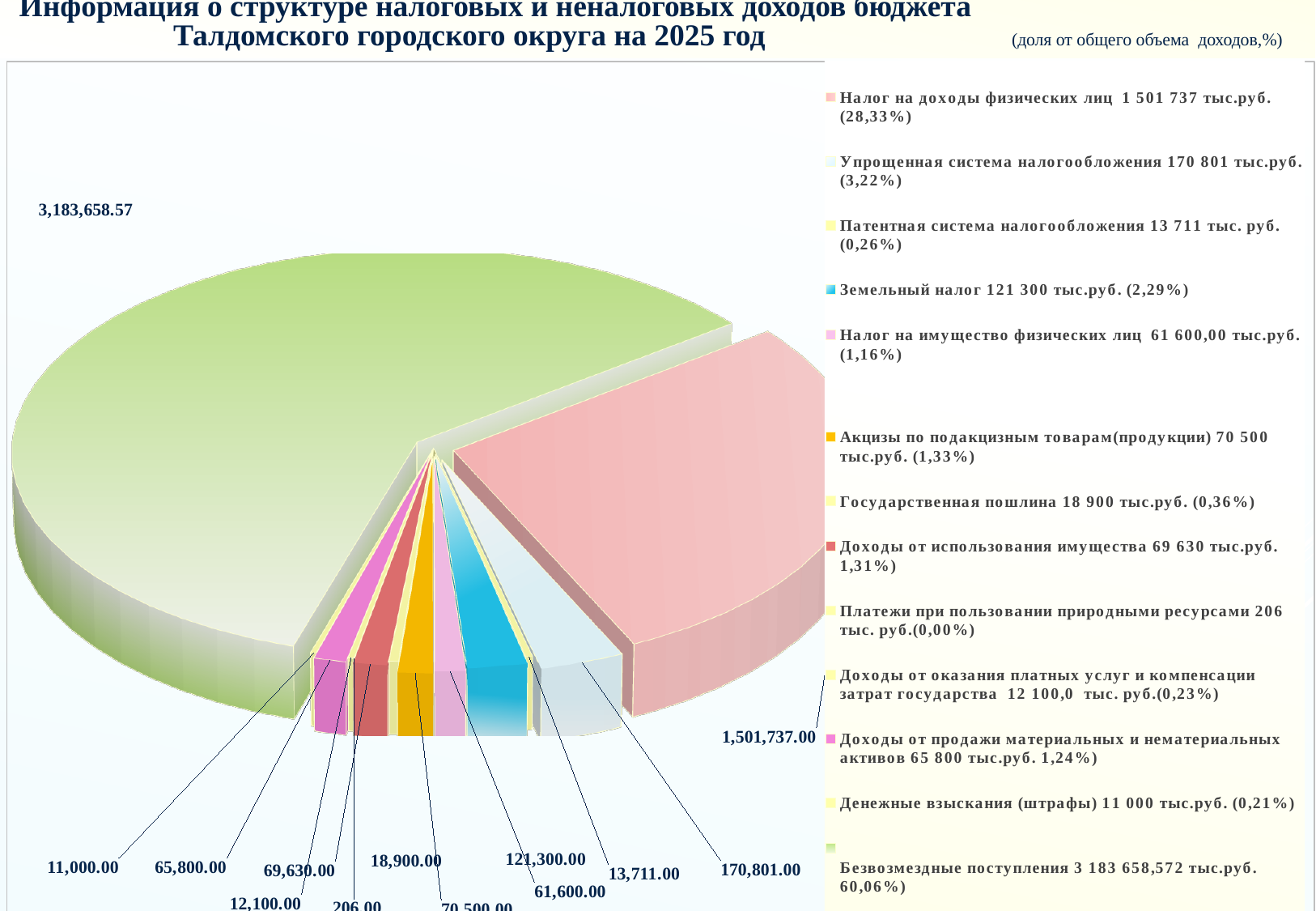
Which is larger: the value for Государственная пошлина or the value for Патентная система налогообложения? Государственная пошлина What share of total revenue does Упрощенная система налогообложения represent according to the legend? 3,22% What is the data label value for Земельный налог? 121,300.00 What share of total revenue does Безвозмездные поступления represent according to the legend? 60,06% What is the difference between the values for Акцизы по подакцизным товарам (70,500.00) and Доходы от использования имущества (69,630.00)? 870.00 What is the data label value for Налог на доходы физических лиц? 1,501,737.00 Which category has the smallest slice of the pie chart? Платежи при пользовании природными ресурсами What colour is the slice for Земельный налог? blue What kind of chart is shown on the slide? pie chart How many categories does the legend of the pie chart list? 13 Which category has the largest slice of the pie chart? Безвозмездные поступления What is the data label value for Безвозмездные поступления? 3,183,658.57